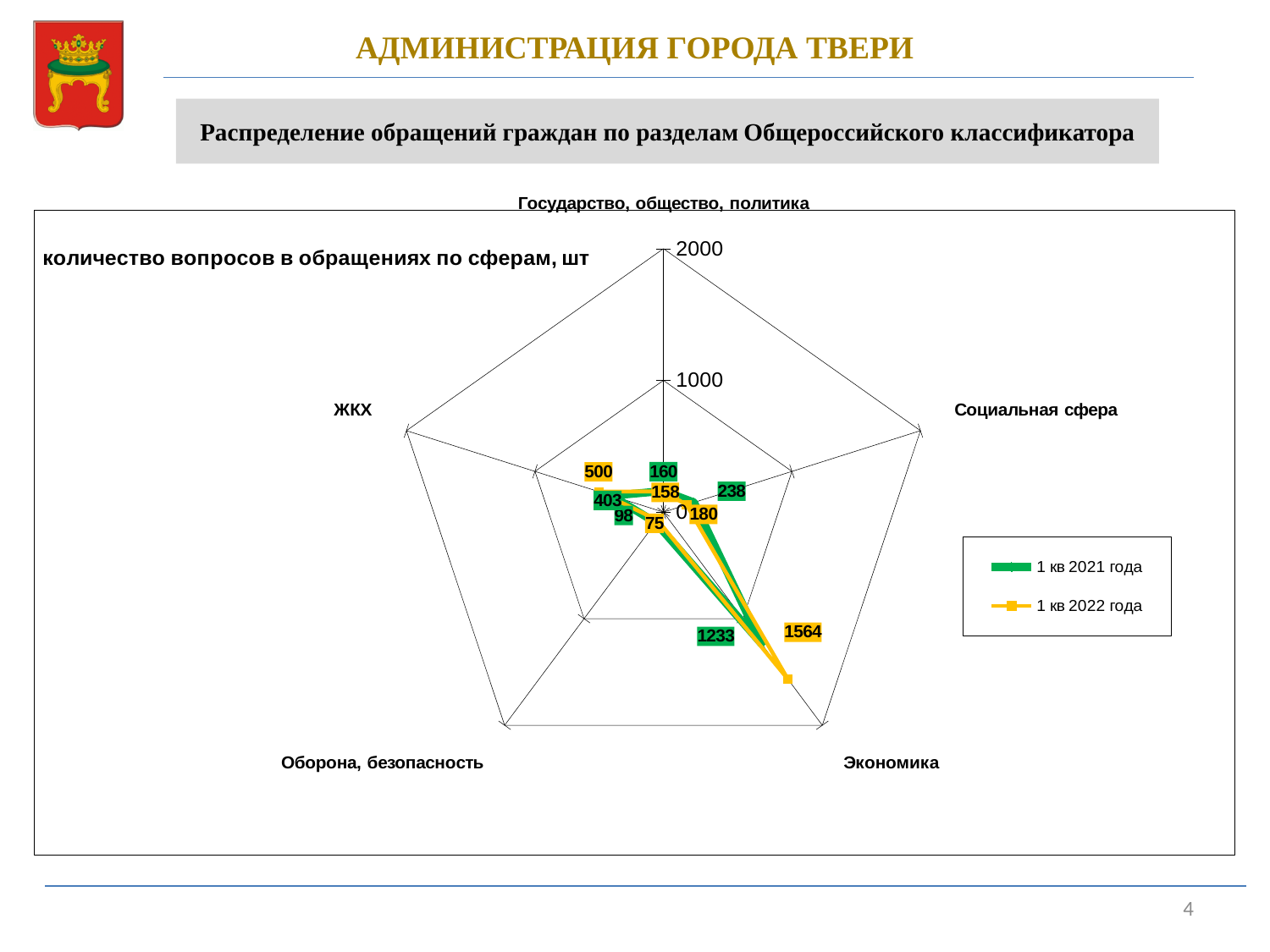
What is the value for Социальная сфера in the 1 кв 2021 года series? 238 How many series does the legend list? 2 What is the value for Оборона, безопасность in the 1 кв 2022 года series? 75 What kind of chart is shown on the slide? radar chart How many categories (axes) does the radar chart have? 5 Which category has the lowest value in the 1 кв 2021 года series? Оборона, безопасность Which category has the highest value in the 1 кв 2022 года series? Экономика What is the difference between the 1 кв 2022 года and 1 кв 2021 года values for Экономика? 331 Which series has the larger value for ЖКХ, 1 кв 2021 года or 1 кв 2022 года? 1 кв 2022 года What is the value for Экономика in the 1 кв 2021 года series? 1233 What is the value for Экономика in the 1 кв 2022 года series? 1564 What is the value for ЖКХ in the 1 кв 2022 года series? 500